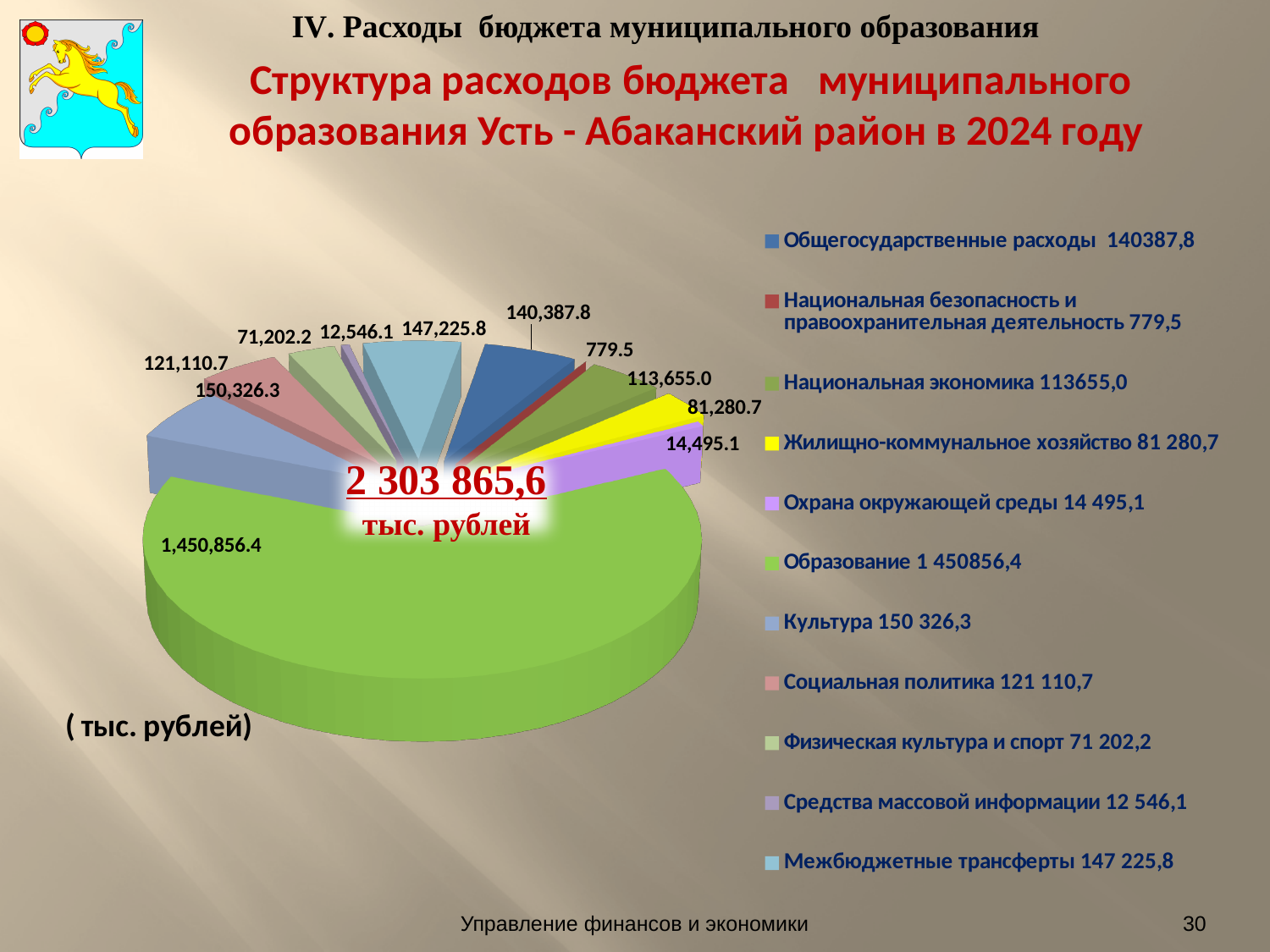
What is the value for Образование on the pie chart? 1,450,856.4 What is the value for Национальная безопасность и правоохранительная деятельность on the pie chart? 779.5 Which is larger, the value for Национальная экономика or the value for Жилищно-коммунальное хозяйство? Национальная экономика What kind of chart is shown on the slide? pie chart Which category has the smallest slice of the pie chart? Национальная безопасность и правоохранительная деятельность Which category has the largest slice of the pie chart? Образование What is the value for Межбюджетные трансферты on the pie chart? 147,225.8 What is the difference between the values for Общегосударственные расходы and Социальная политика? 19,277.1 How many categories does the pie chart have? 11 What total amount is printed in the centre of the pie chart? 2 303 865,6 тыс. рублей What is the value for Культура on the pie chart? 150,326.3 What is the difference between the values for Культура and Межбюджетные трансферты? 3,100.5